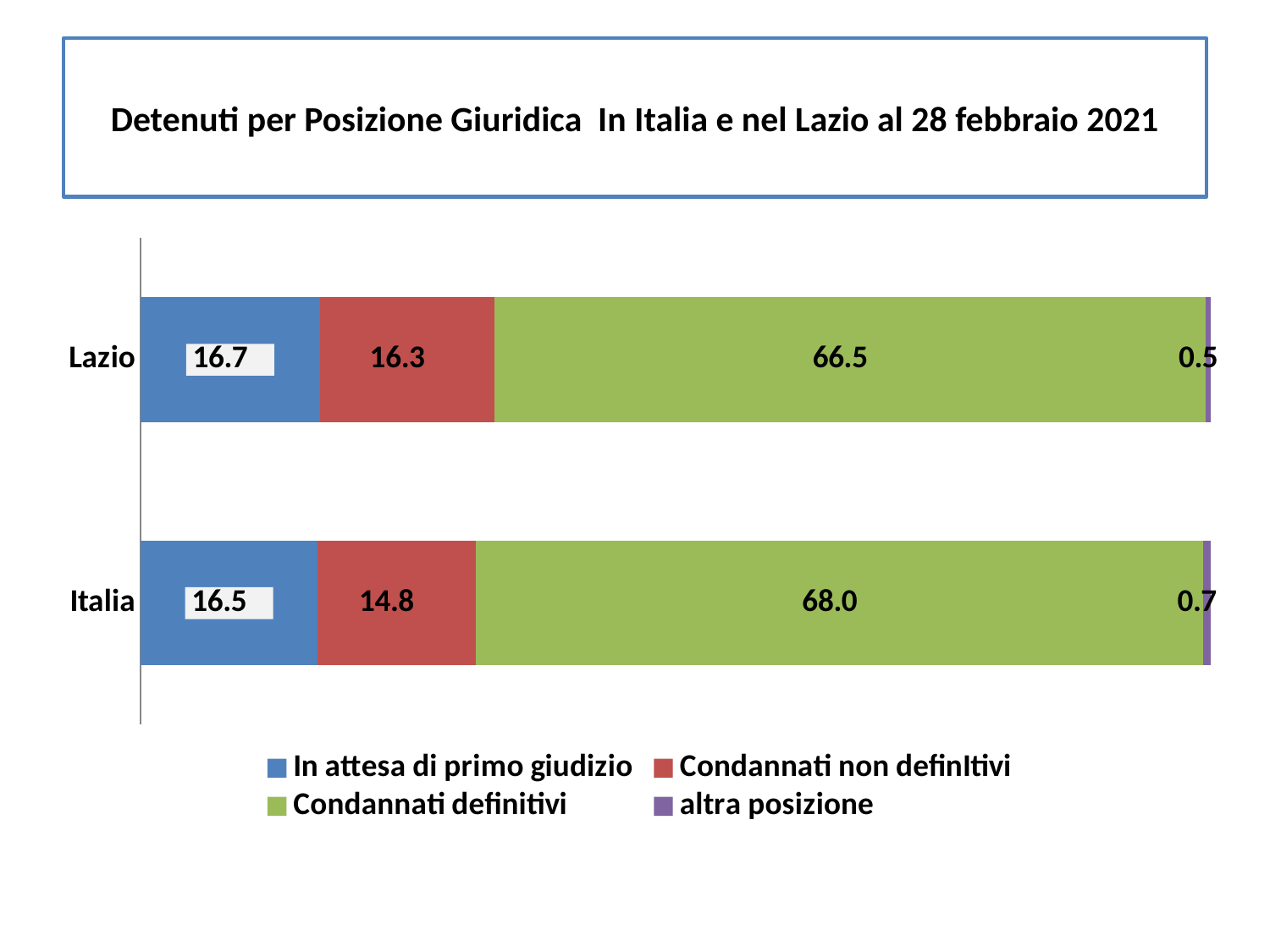
What is the value for "Condannati non definItivi" for Italia? 14.8 Which series has the smallest value for Lazio? altra posizione How many series does the legend list? 4 Which series has the largest value for Italia? Condannati definitivi How many categories are shown on the chart? 2 What is the value for "In attesa di primo giudizio" for Lazio? 16.7 What is the value for "Condannati definitivi" for Lazio? 66.5 What is the difference between the "Condannati definitivi" values for Italia and Lazio? 1.5 What is the value for "altra posizione" for Italia? 0.7 What is the total of the stacked bar for Lazio? 100.0 Which is larger, the "Condannati non definItivi" value for Lazio or for Italia? Lazio What kind of chart is shown on the slide? Stacked bar chart